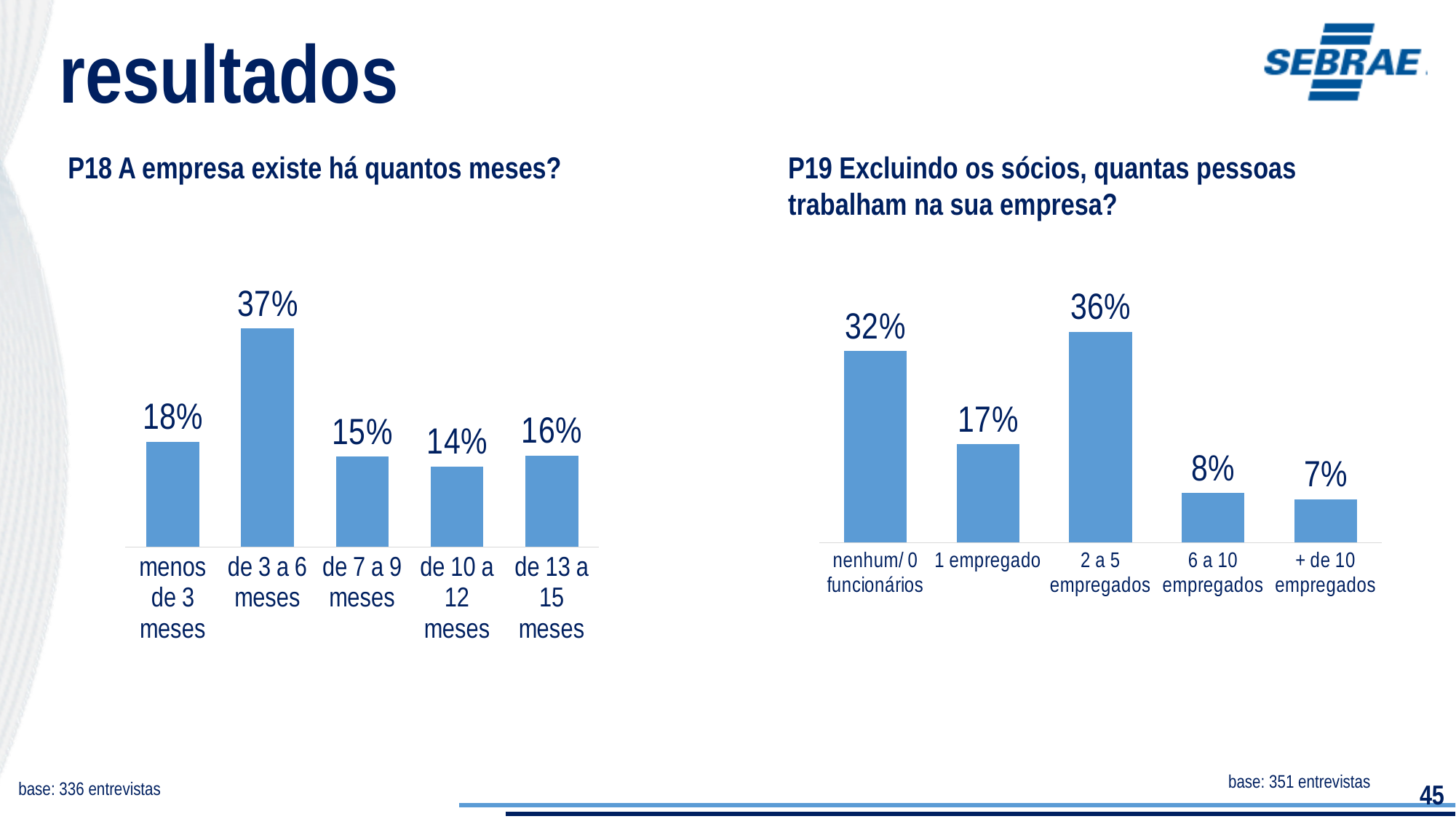
In the right chart (P19 Excluindo os sócios, quantas pessoas trabalham na sua empresa?), what is the value for 'nenhum/ 0 funcionários'? 32% In the right chart (P19), what is the value for '6 a 10 empregados'? 8% In the right chart (P19), which category has the lowest value? + de 10 empregados In the right chart (P19), which is larger: '1 empregado' or '6 a 10 empregados'? 1 empregado In the left chart (P18 A empresa existe há quantos meses?), what is the value for 'de 3 a 6 meses'? 37% In the left chart (P18), which category has the lowest value? de 10 a 12 meses In the left chart (P18), what is the difference between 'de 3 a 6 meses' and 'menos de 3 meses'? 19 percentage points In the left chart (P18), what is the value for 'de 10 a 12 meses'? 14% In the left chart (P18), which category has the highest value? de 3 a 6 meses What type of chart is used for P19 on the right? Bar chart In the left chart (P18), how many categories are shown? 5 In the right chart (P19), which category has the highest value? 2 a 5 empregados